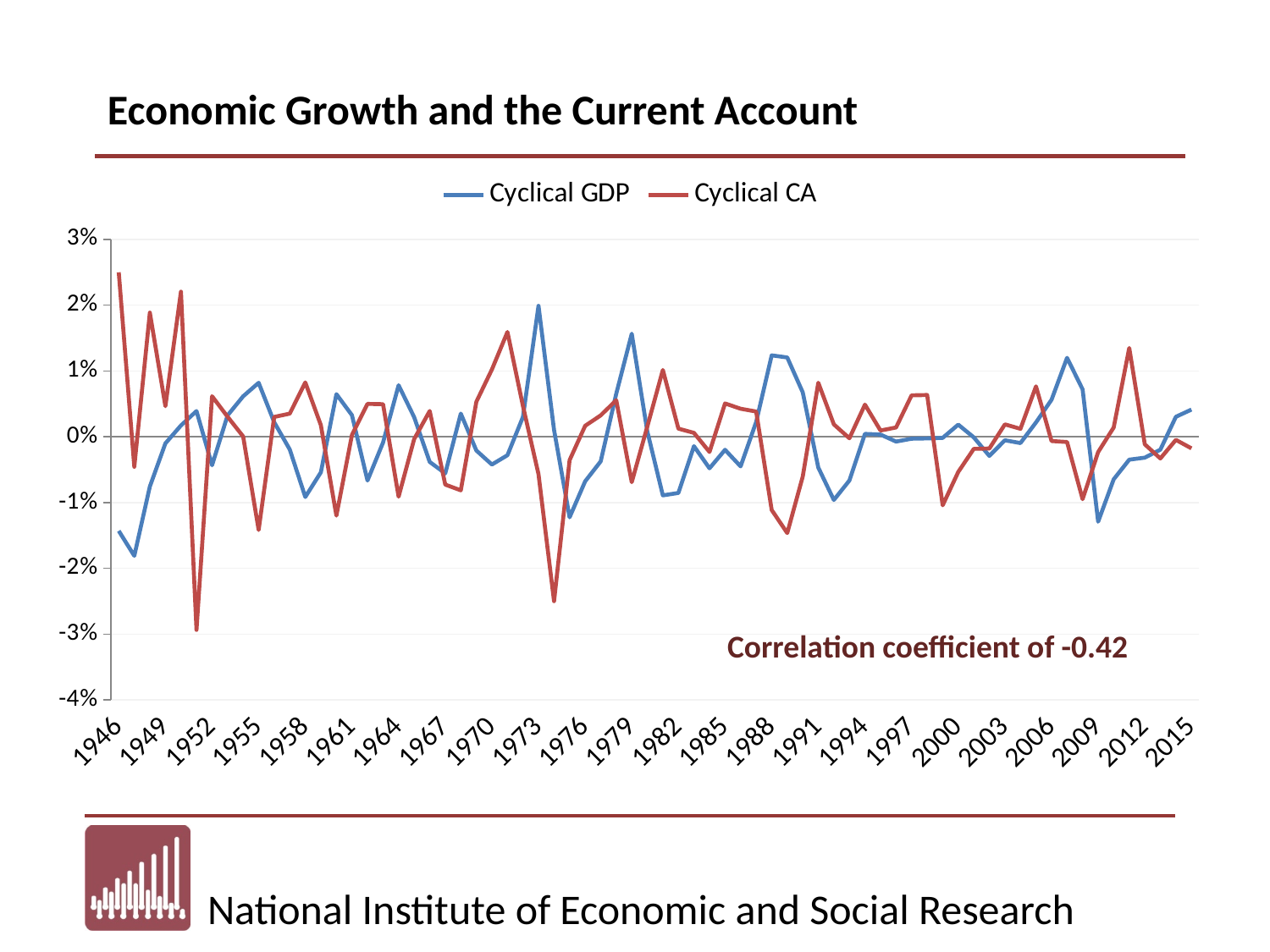
In which year does the Cyclical GDP series reach its lowest value? 1947 Is the value for Cyclical GDP in 1979 greater or less than 1%? greater What are the two series named in the legend? Cyclical GDP and Cyclical CA Is the value for Cyclical CA in 1974 greater or less than -2%? less How many series does the legend list? 2 In 1951, which series has the higher value, Cyclical GDP or Cyclical CA? Cyclical GDP Is the value for Cyclical GDP in 2009 greater or less than -1%? less In which year does the Cyclical GDP series reach its highest value? 1973 What kind of chart is shown on the slide? line chart In which year does the Cyclical CA series reach its lowest value? 1951 What correlation coefficient is stated on the chart? -0.42